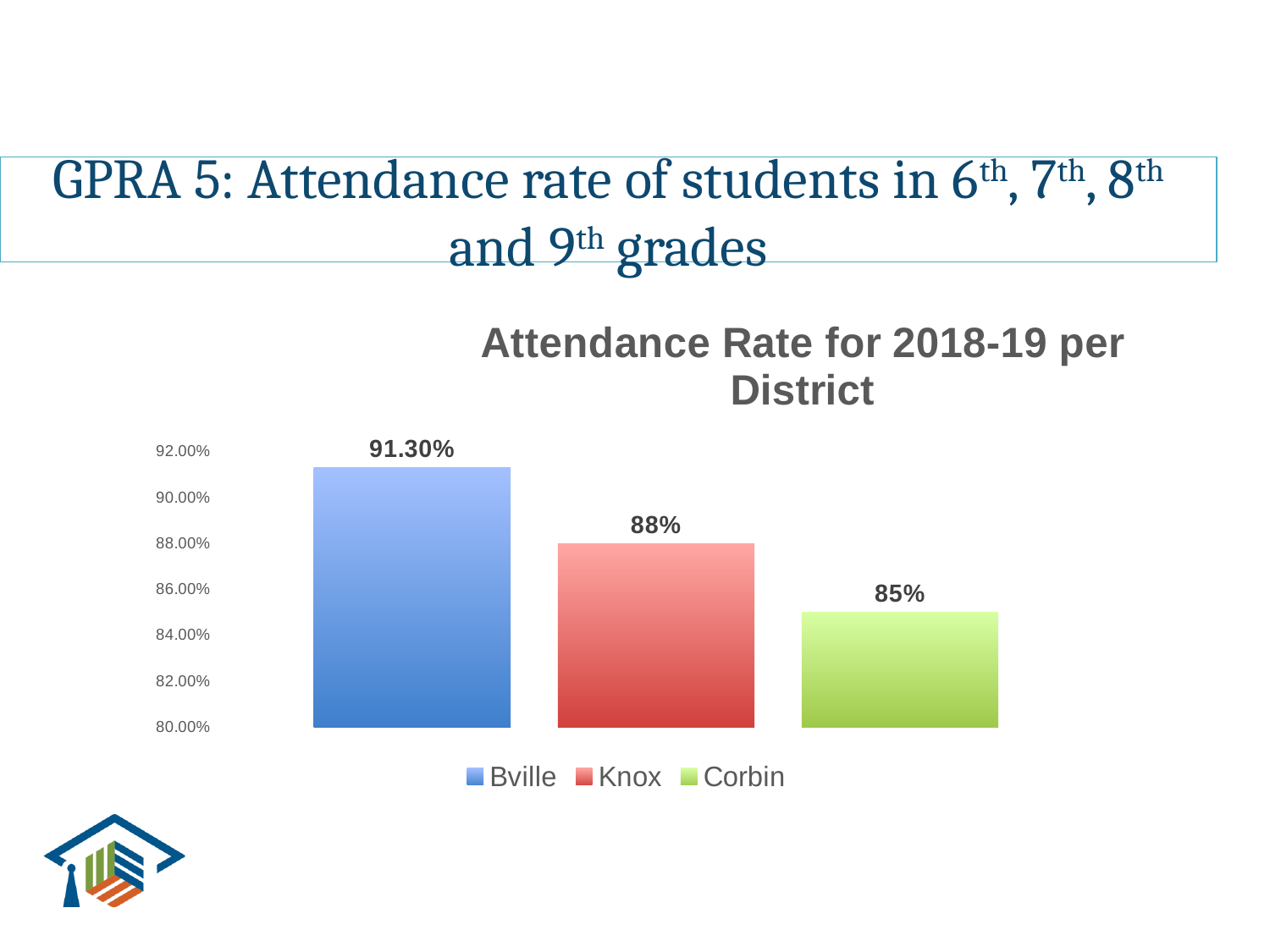
Which district has the highest attendance rate? Bville Which district has a higher attendance rate, Knox or Corbin? Knox Is the attendance rate for Bville greater or less than 90.00%? greater What is the difference between the attendance rates of Knox and Corbin? 3% Which district has the lowest attendance rate? Corbin What is the attendance rate for Bville? 91.30% What is the title of the chart? Attendance Rate for 2018-19 per District How many entries does the legend list? 3 What kind of chart is shown on the slide? Bar chart How many districts are shown in the chart? 3 What is the attendance rate for Knox? 88% What is the attendance rate for Corbin? 85%